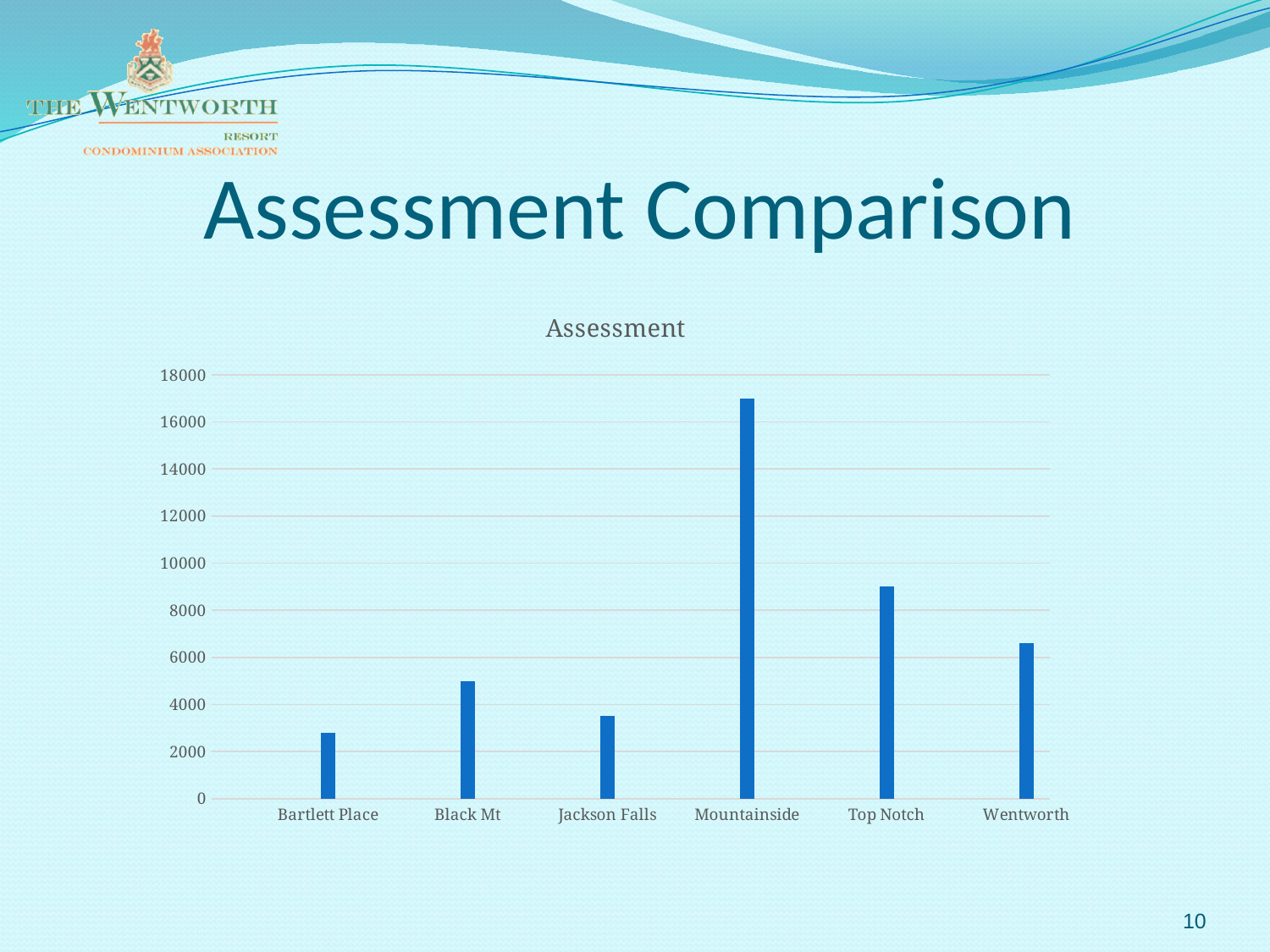
What kind of chart is shown on the slide? bar chart Is the value for Wentworth greater or less than 6000? greater What is the title of the chart? Assessment Is the value for Bartlett Place greater or less than 4000? less Is the value for Top Notch greater or less than 8000? greater How many categories are shown on the x axis of the chart? 6 Which category has the lowest assessment value? Bartlett Place Which category has the highest assessment value? Mountainside Which is larger, the value for Black Mt or the value for Jackson Falls? Black Mt Which is larger, the value for Top Notch or the value for Wentworth? Top Notch